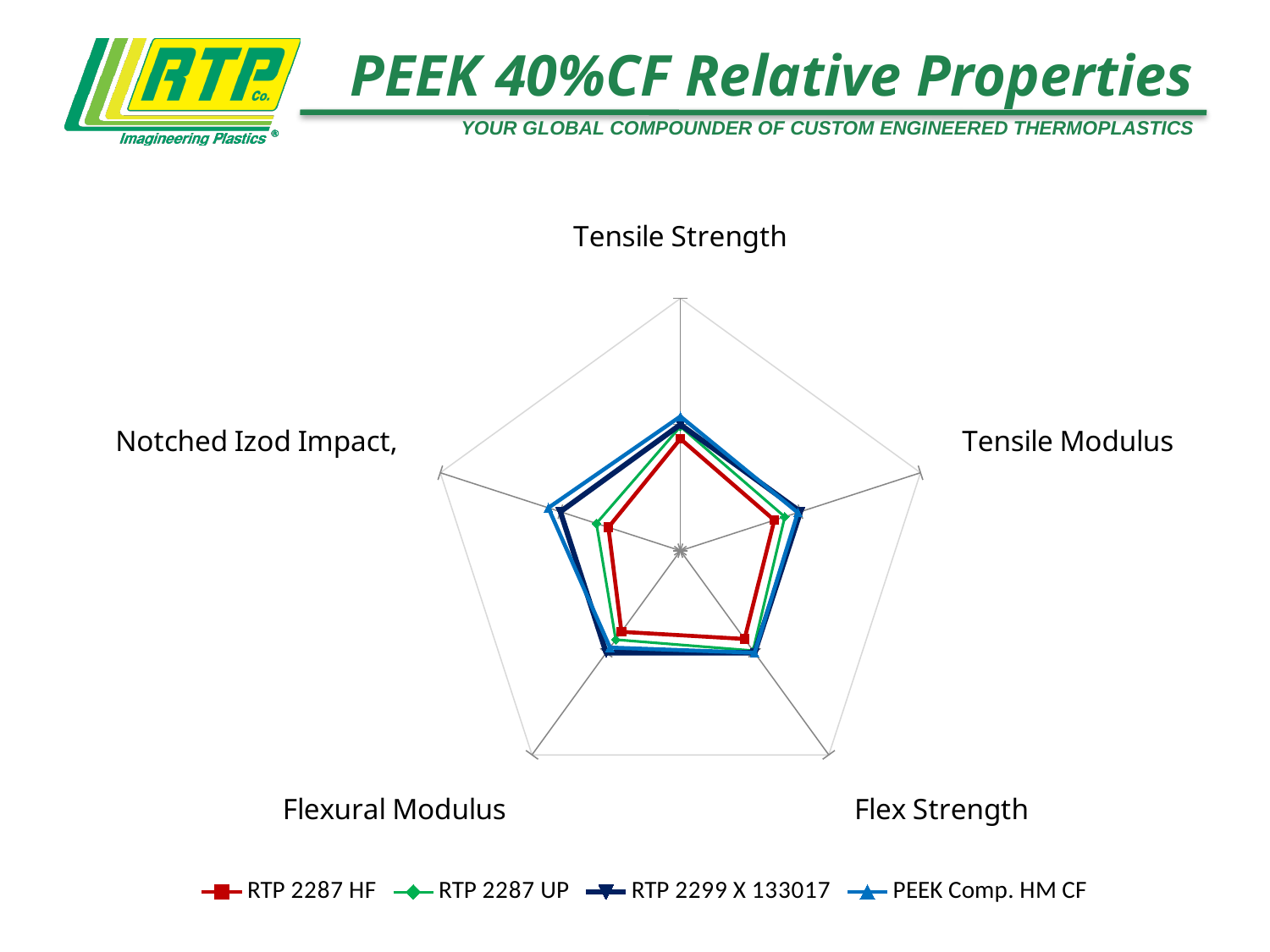
How many series does the legend list? 4 How many property axes (categories) does the radar chart have? 5 Which series has the lowest value on the Flex Strength axis? RTP 2287 HF On the Tensile Modulus axis, which is larger: RTP 2287 HF or RTP 2287 UP? RTP 2287 UP Which series has the lowest value on the Tensile Strength axis? RTP 2287 HF What is the title of the chart slide? PEEK 40%CF Relative Properties Which series has the lowest value on the Notched Izod Impact axis? RTP 2287 HF What kind of chart is shown on the slide? Radar chart Which series has the highest value on the Notched Izod Impact axis? PEEK Comp. HM CF On the Flexural Modulus axis, which is larger: RTP 2287 HF or PEEK Comp. HM CF? PEEK Comp. HM CF On the Notched Izod Impact axis, which is larger: RTP 2287 UP or RTP 2299 X 133017? RTP 2299 X 133017 Which series is shown with red square markers in the legend? RTP 2287 HF